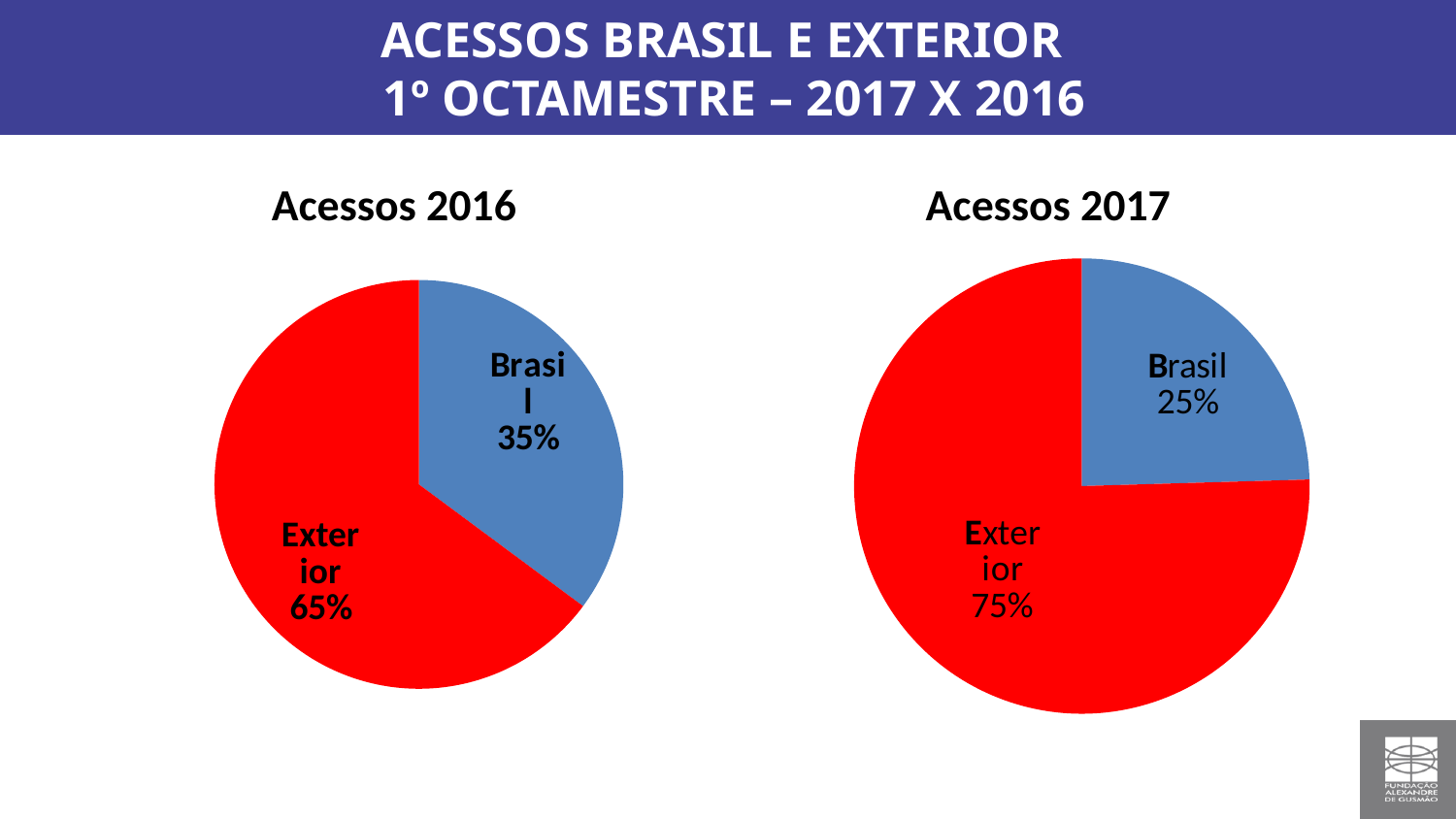
Is the Brasil share larger in the 'Acessos 2016' chart or the 'Acessos 2017' chart? Acessos 2016 In the 'Acessos 2017' chart, what share of accesses is from Exterior? 75% In the 'Acessos 2016' chart, what share of accesses is from Exterior? 65% In the 'Acessos 2017' chart, what colour is the Exterior slice? Red In the 'Acessos 2016' chart, what share of accesses is from Brasil? 35% In the 'Acessos 2017' chart, what is the difference in percentage points between Exterior and Brasil? 50 In the 'Acessos 2016' chart, what is the difference in percentage points between Exterior and Brasil? 30 How many slices does the 'Acessos 2017' chart have? 2 In the 'Acessos 2017' chart, what share of accesses is from Brasil? 25% In the 'Acessos 2016' chart, which slice is the smallest? Brasil In the 'Acessos 2017' chart, which slice is the largest? Exterior What type of chart is the 'Acessos 2016' chart? Pie chart